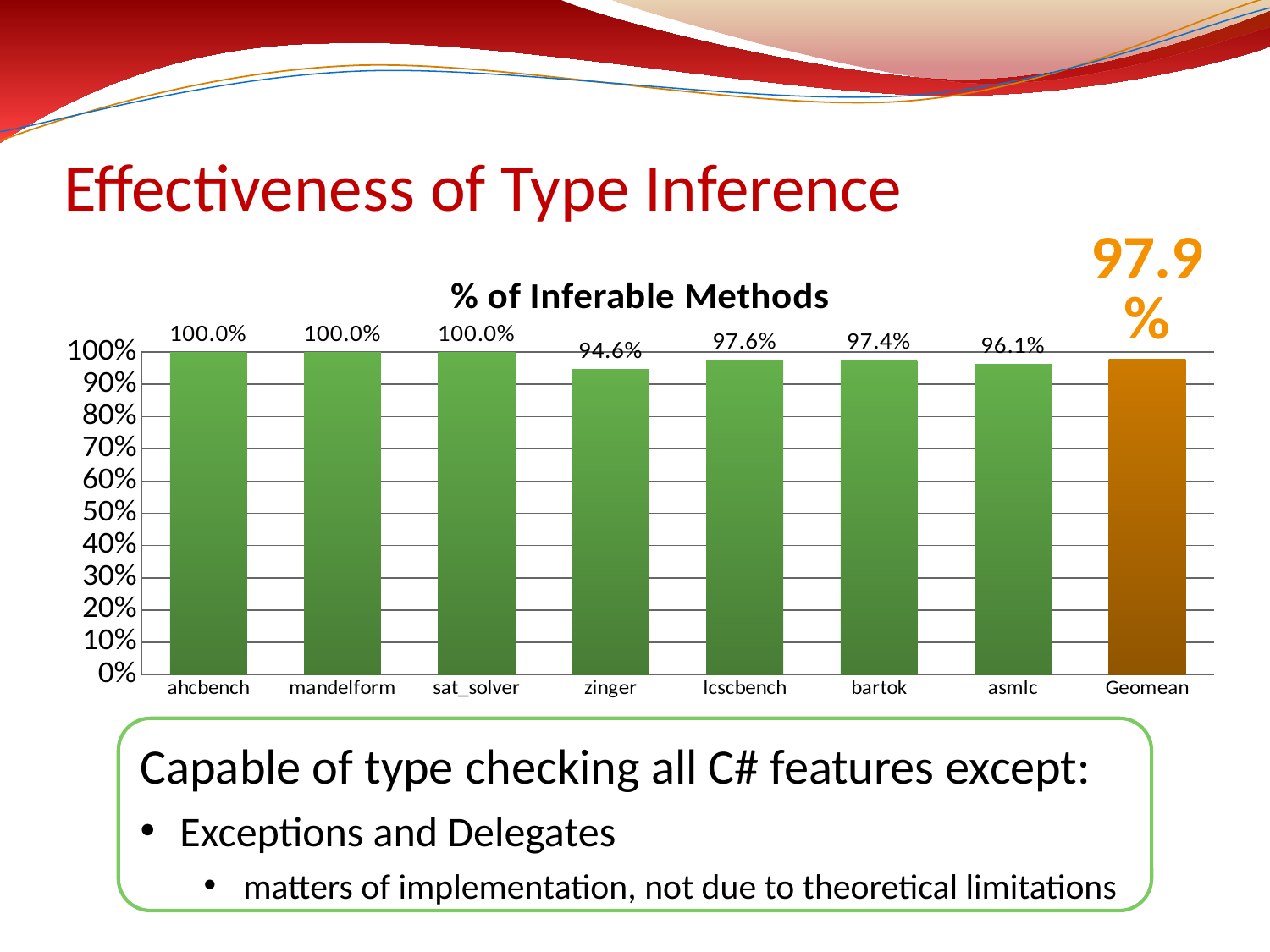
What is the value for Geomean? 97.9% Which is larger, the value for lcscbench or the value for asmlc? lcscbench How many categories are shown on the x axis? 8 What is the value for zinger? 94.6% What is the difference between the values for lcscbench and bartok? 0.2% What is the value for bartok? 97.4% What is the difference between the values for ahcbench and zinger? 5.4% Which category has the lowest value? zinger What kind of chart is shown? Bar chart What is the title of the chart? % of Inferable Methods What is the value for asmlc? 96.1% What is the value for lcscbench? 97.6%